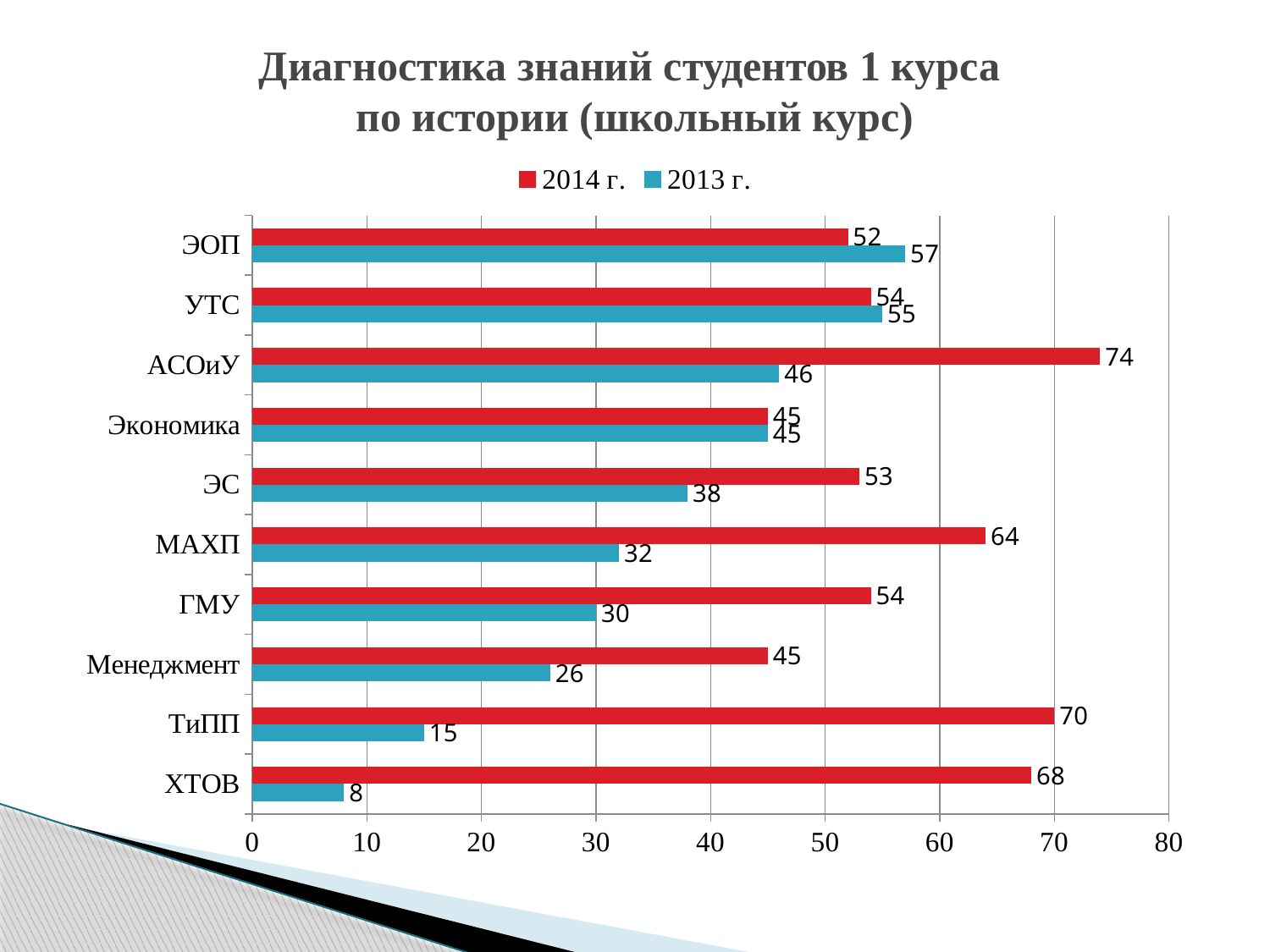
What is the value for ХТОВ in 2013 г.? 8 Which is larger for ЭОП: the 2014 г. value or the 2013 г. value? 2013 г. How many categories (groups) are shown on the chart? 10 How many series does the legend list? 2 What is the difference between the 2014 г. and 2013 г. values for МАХП? 32 Is the 2014 г. value for ТиПП greater or less than 60? greater Which category has the lowest value in the 2013 г. series? ХТОВ What type of chart is shown on the slide? Bar chart Which colour represents the 2013 г. series? Blue What is the value for АСОиУ in 2014 г.? 74 Which category has the highest value in the 2014 г. series? АСОиУ What is the value for ТиПП in 2013 г.? 15